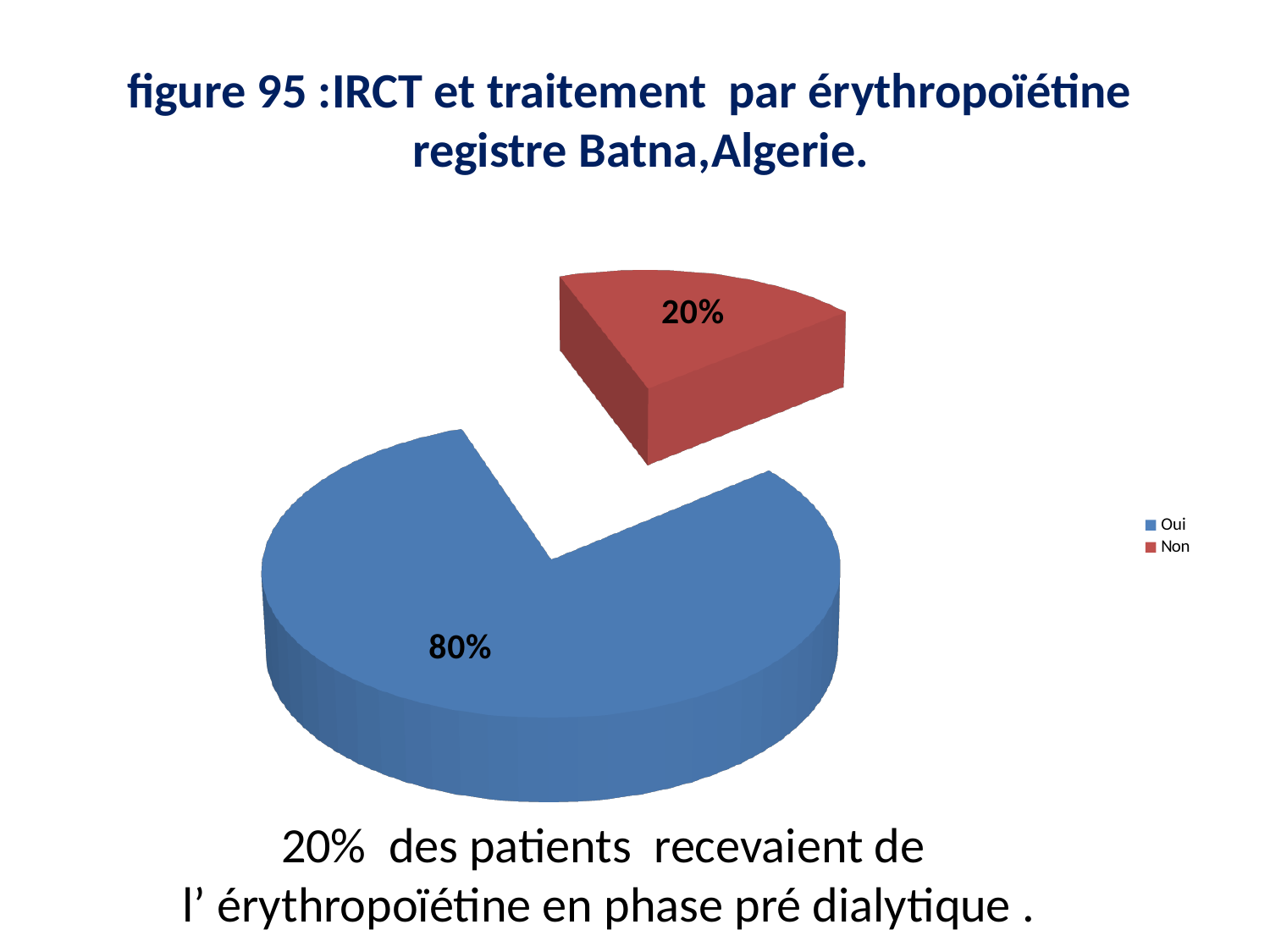
What percentage does the 'Non' slice represent? 20% Which category has the smallest share of the pie? Non What share of the pie does the 'Non' slice take? 20% What colour is the 'Oui' slice? blue What percentage does the 'Oui' slice represent? 80% How many entries does the legend list? 2 What kind of chart is shown on the slide? pie chart Which is larger, the 'Oui' slice or the 'Non' slice? Oui What colour is the 'Non' slice? red Which category has the largest share of the pie? Oui How many slices does the pie chart have? 2 What is the difference in percentage points between the 'Oui' and 'Non' slices? 60